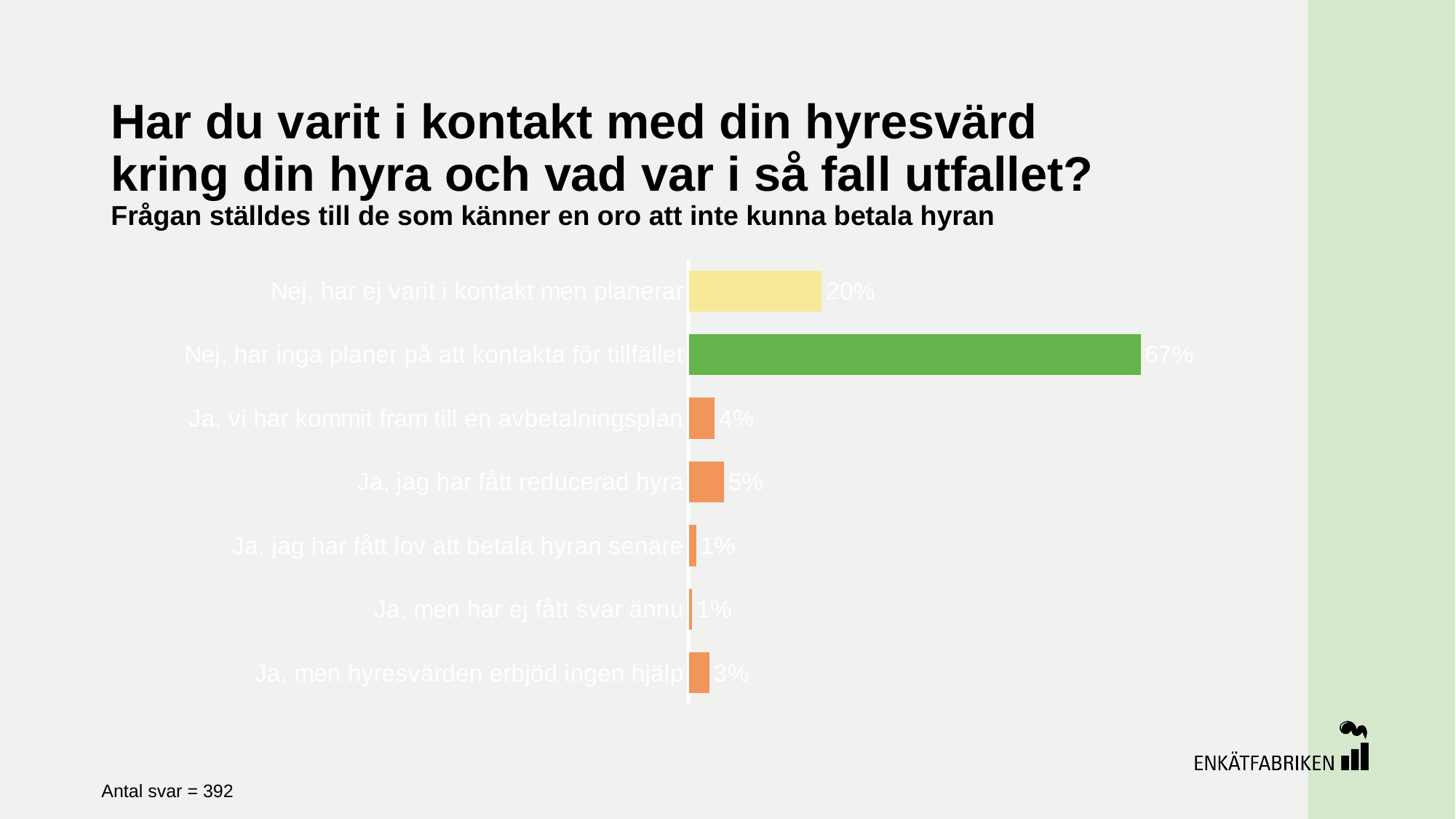
How many responses (Antal svar) does the slide report for this question? 392 What is the value for "Nej, har ej varit i kontakt men planerar"? 20% Which is larger: the value for "Ja, jag har fått reducerad hyra" or the value for "Ja, vi har kommit fram till en avbetalningsplan"? Ja, jag har fått reducerad hyra What is the value for "Ja, jag har fått reducerad hyra"? 5% What is the difference between the values for "Nej, har inga planer på att kontakta för tillfället" and "Nej, har ej varit i kontakt men planerar"? 47% How many categories are shown in the chart? 7 Which category has the highest value? Nej, har inga planer på att kontakta för tillfället What is the difference between the values for "Ja, jag har fått reducerad hyra" and "Ja, men hyresvärden erbjöd ingen hjälp"? 2% What colour is the bar for "Nej, har inga planer på att kontakta för tillfället"? green What is the value for "Ja, men hyresvärden erbjöd ingen hjälp"? 3% What kind of chart is shown on the slide? bar chart What is the value for "Nej, har inga planer på att kontakta för tillfället"? 67%